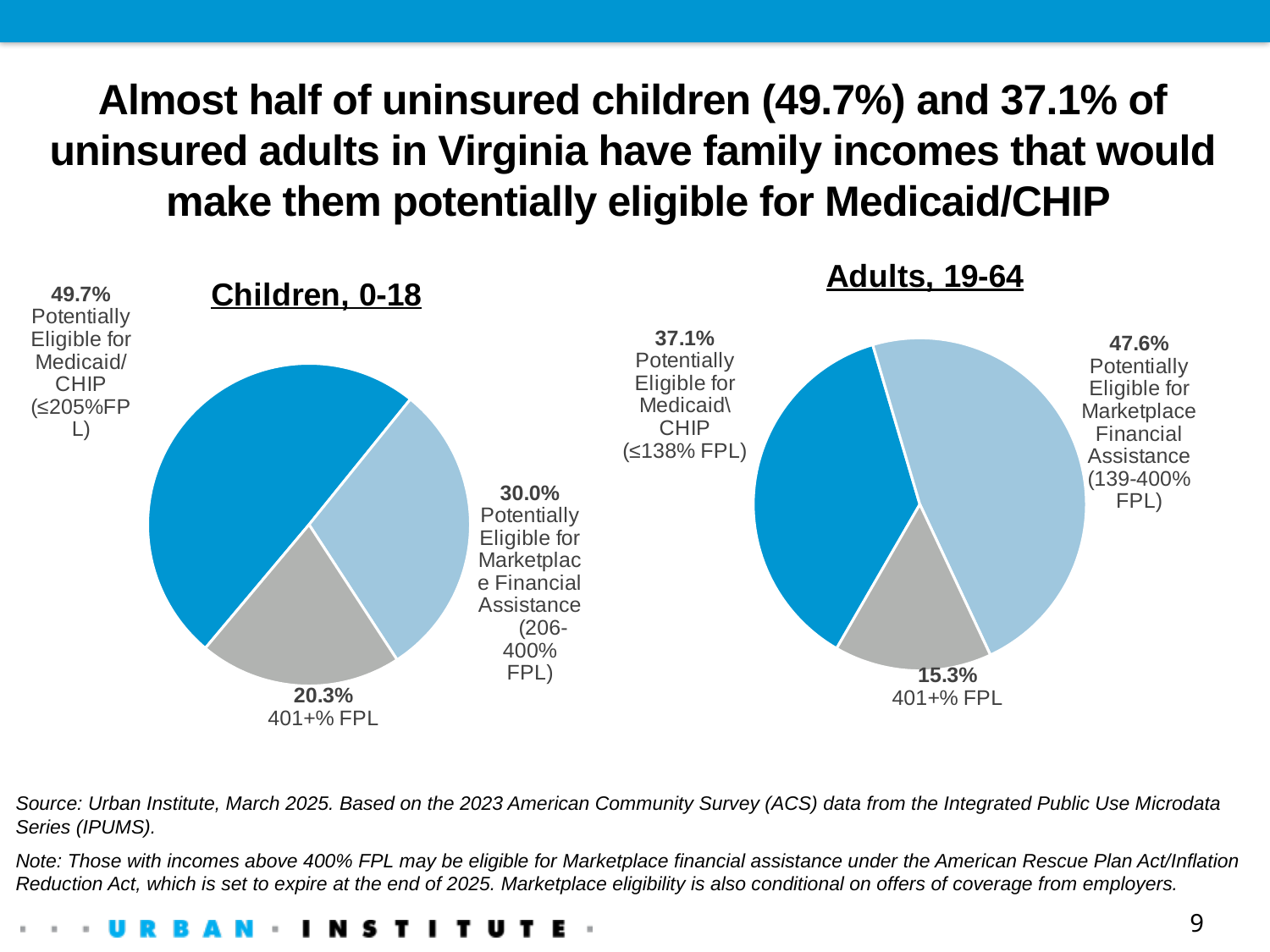
In the Adults, 19-64 chart, what share of uninsured adults are potentially eligible for Marketplace Financial Assistance (139-400% FPL)? 47.6% In the Children, 0-18 chart, what colour is the 401+% FPL slice? Gray How many slices does the Adults, 19-64 pie chart have? 3 Which is larger: the 401+% FPL share in the Children, 0-18 chart or the 401+% FPL share in the Adults, 19-64 chart? Children, 0-18 In the Adults, 19-64 chart, what share of uninsured adults have family incomes of 401+% FPL? 15.3% In the Children, 0-18 chart, what share of uninsured children are potentially eligible for Medicaid/CHIP (≤205% FPL)? 49.7% In the Adults, 19-64 chart, what is the difference between the Marketplace Financial Assistance share and the Medicaid/CHIP share? 10.5% In the Adults, 19-64 chart, which slice is the smallest? 401+% FPL In the Children, 0-18 chart, what is the difference between the Medicaid/CHIP share and the Marketplace Financial Assistance share? 19.7% In the Children, 0-18 chart, which slice is the largest? Potentially Eligible for Medicaid/CHIP (≤205% FPL) In the Children, 0-18 chart, what share of uninsured children have family incomes of 401+% FPL? 20.3% What type of chart is used for the Children, 0-18 data? Pie chart